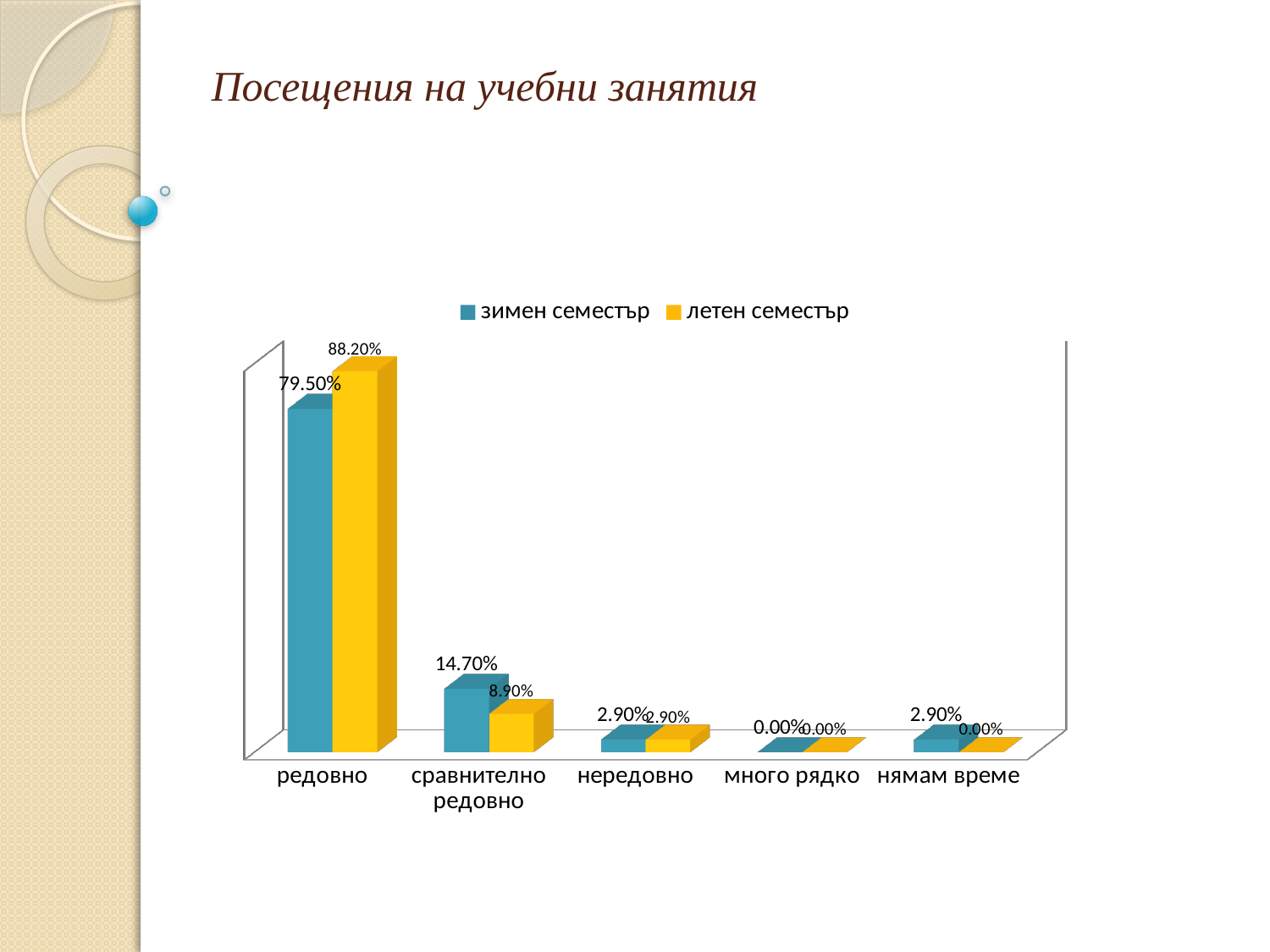
What is the difference between the "зимен семестър" and "летен семестър" values for "сравнително редовно"? 5.80% How many categories are shown on the x axis? 5 What is the value for "нямам време" in the "зимен семестър" series? 2.90% What kind of chart is shown on the slide? bar chart Which category has the lowest value in the "зимен семестър" series? много рядко Which category has the highest value in the "летен семестър" series? редовно What is the value for "сравнително редовно" in the "летен семестър" series? 8.90% How many series does the legend list? 2 What is the value for "редовно" in the "летен семестър" series? 88.20% What is the difference between the "летен семестър" and "зимен семестър" values for "редовно"? 8.70% What is the value for "редовно" in the "зимен семестър" series? 79.50% For "сравнително редовно", which series has the larger value, "зимен семестър" or "летен семестър"? зимен семестър